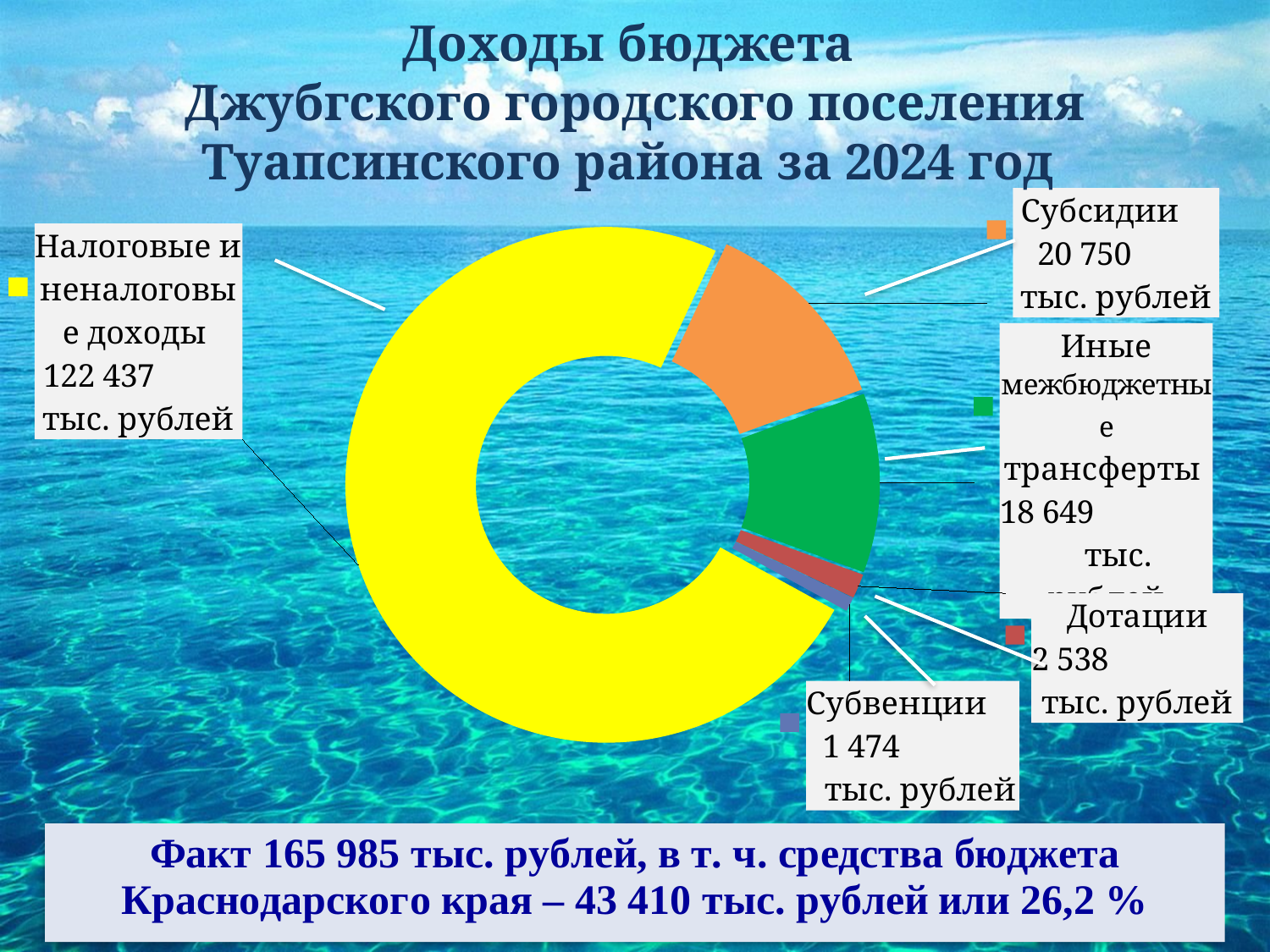
Which is larger, Субсидии or Иные межбюджетные трансферты? Субсидии What is the value for Дотации? 2 538 тыс. рублей What type of chart is shown on the slide? doughnut chart How many categories does the chart show? 5 What colour is the segment for Налоговые и неналоговые доходы? yellow Which category has the largest share of the chart? Налоговые и неналоговые доходы What is the value for Налоговые и неналоговые доходы? 122 437 тыс. рублей What is the value for Субвенции? 1 474 тыс. рублей What is the value for Субсидии? 20 750 тыс. рублей What is the value for Иные межбюджетные трансферты? 18 649 тыс. рублей Which category has the smallest value? Субвенции What is the difference between Субсидии and Иные межбюджетные трансферты? 2 101 тыс. рублей